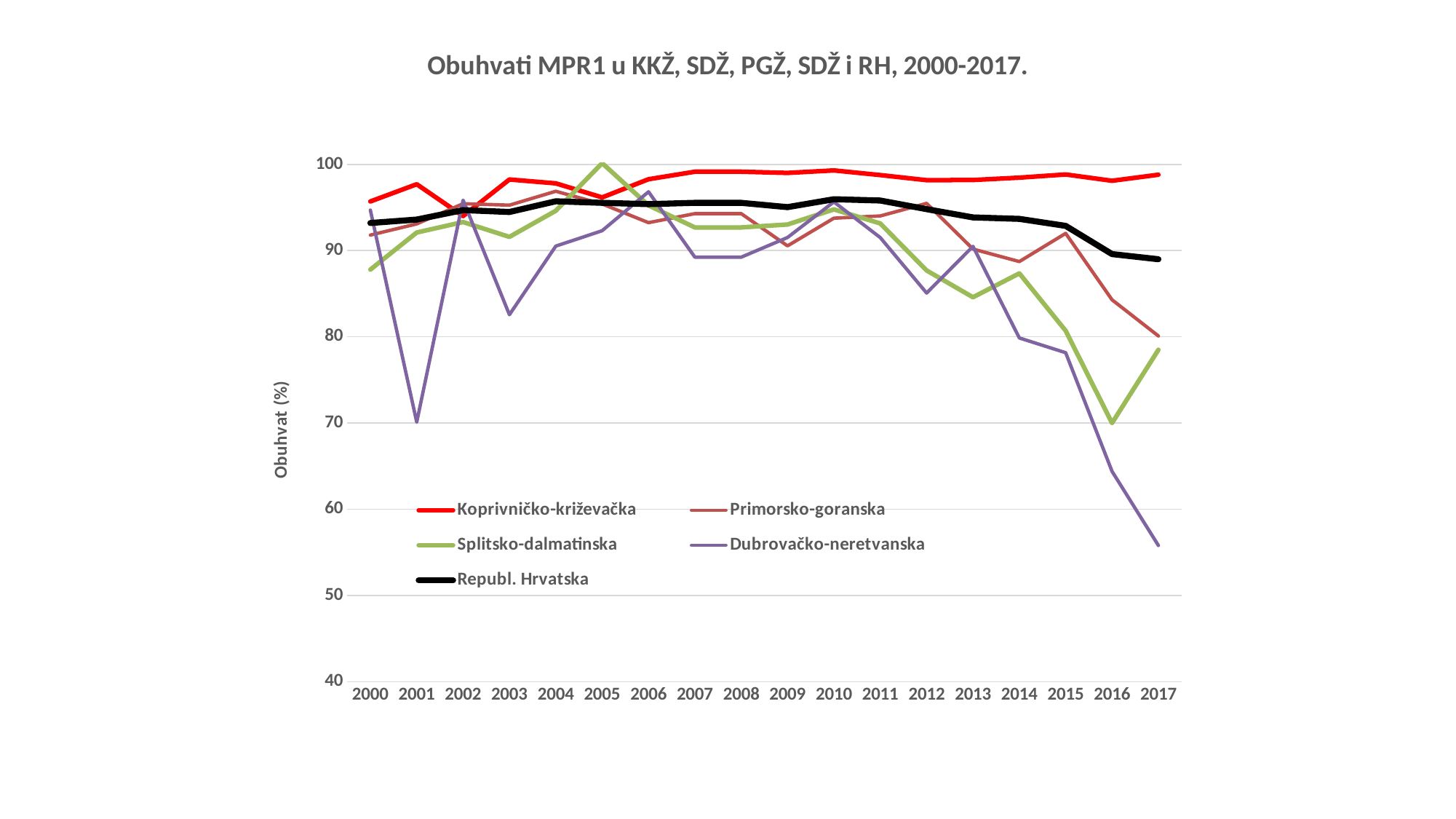
What colour is the Republ. Hrvatska line? black How many years are shown along the x axis? 18 In 2016, which is higher: Koprivničko-križevačka or Republ. Hrvatska? Koprivničko-križevačka Which series has the lowest value in 2017? Dubrovačko-neretvanska What kind of chart is shown on the slide? line chart Is the value for Koprivničko-križevačka in 2017 greater or less than 90? greater Is the value for Dubrovačko-neretvanska in 2017 greater or less than 60? less Which series has the lowest value in 2001? Dubrovačko-neretvanska Is the value for Dubrovačko-neretvanska in 2016 greater or less than 70? less Does the Dubrovačko-neretvanska line rise or fall from 2013 to 2017? fall How many series does the legend list? 5 Which series has the highest value in 2017? Koprivničko-križevačka